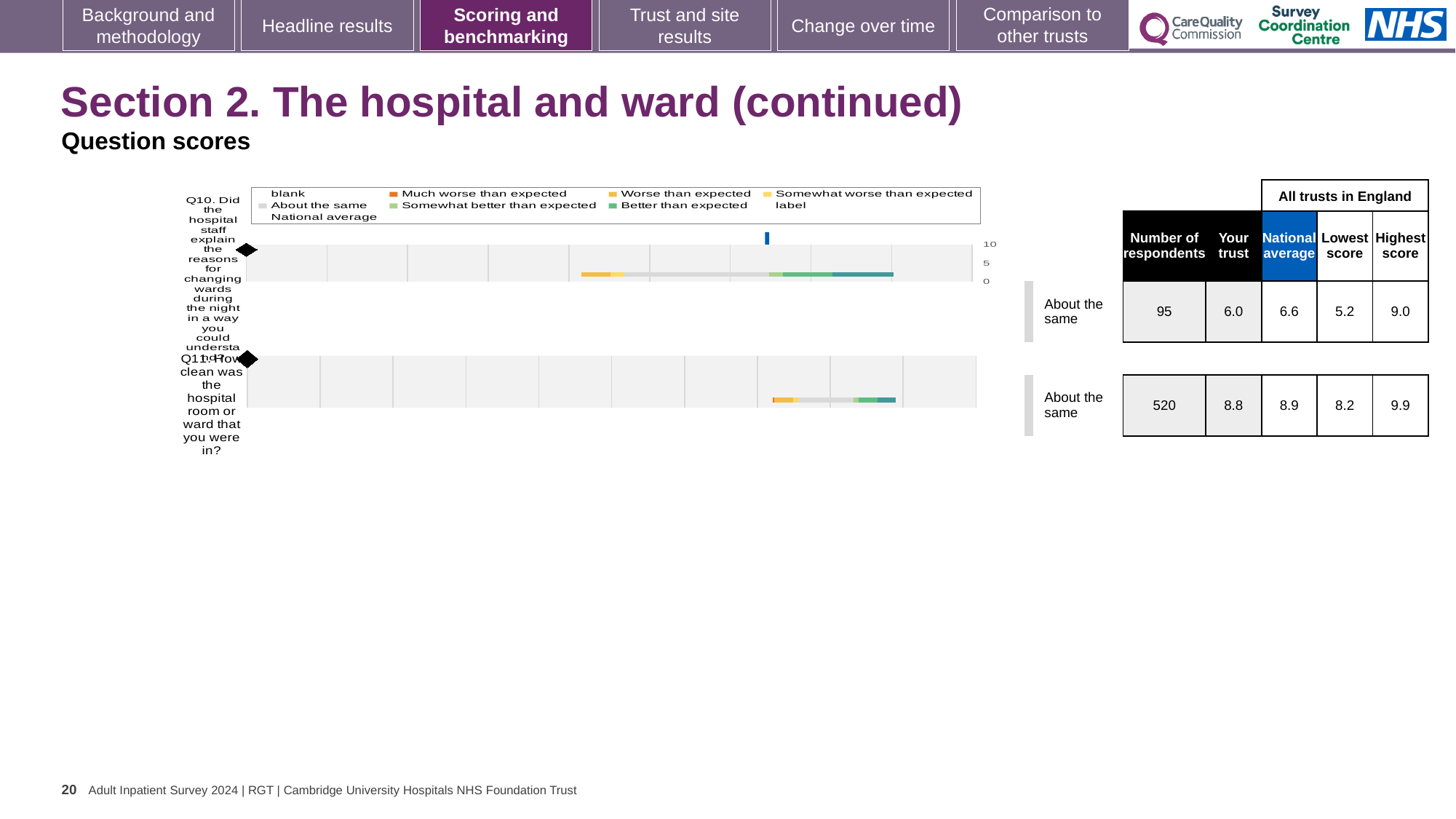
What is the difference between the national average and the 'Your trust' score for Q10? 0.6 How many questions are plotted in the chart? 2 For Q10, which is larger: the 'Your trust' score or the national average? National average What is the 'Your trust' score for Q11 (How clean was the hospital room or ward that you were in?)? 8.8 What kind of chart is used to show the question scores on this slide? bar chart What is the highest score across all trusts in England for Q11? 9.9 What is the lowest score across all trusts in England for Q10? 5.2 How many respondents answered Q11? 520 What is the difference between the highest and lowest scores for Q11? 1.7 What is the national average score for Q10 (Did the hospital staff explain the reasons for changing wards during the night)? 6.6 What benchmark category is shown for Q10? About the same Which question has more respondents, Q10 or Q11? Q11